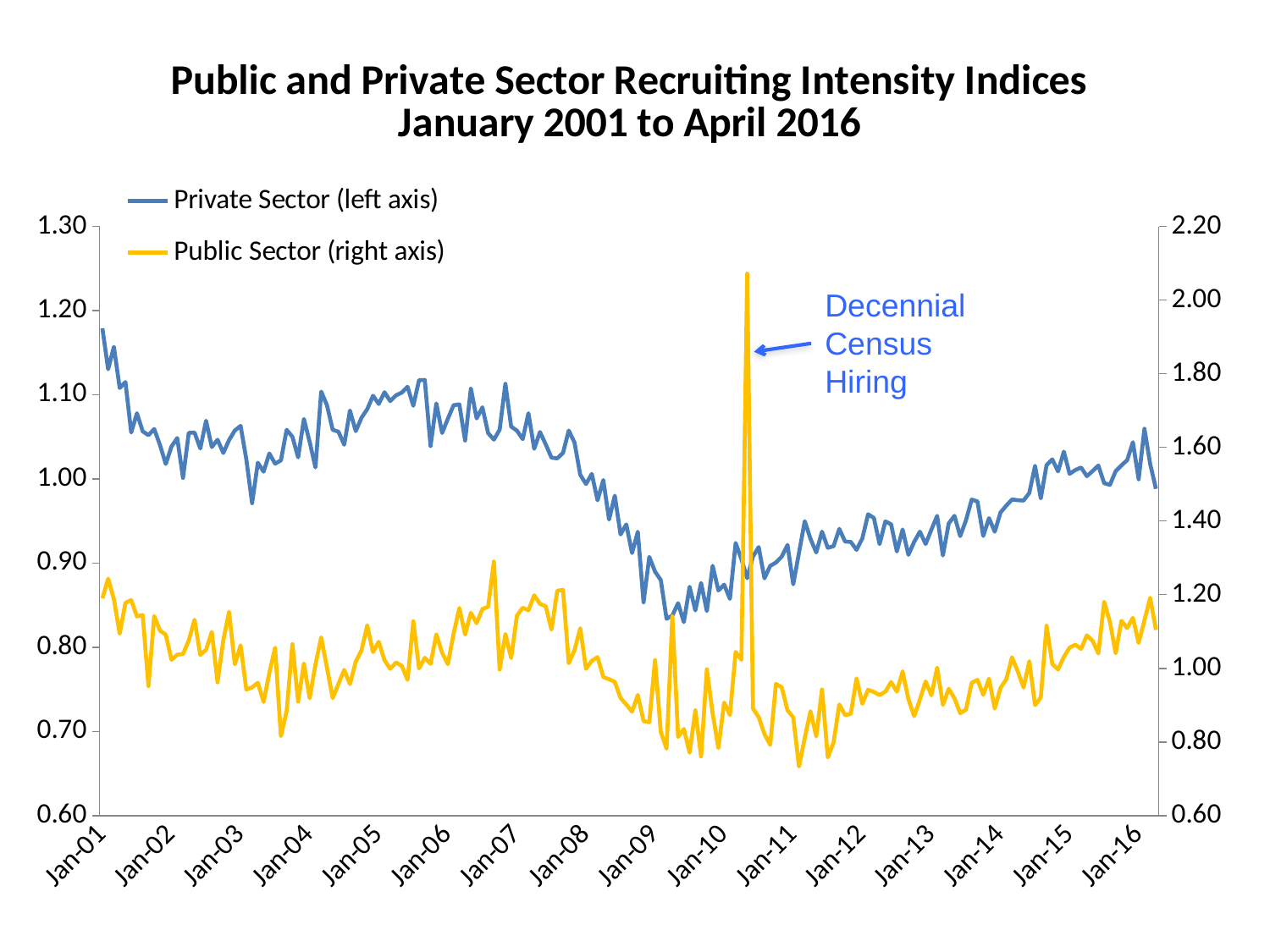
Is the Private Sector value at Jan-01 greater or less than 1.10? greater Which axis is the Public Sector series plotted against? right axis Is the Public Sector value at Jan-01 (right axis) greater or less than 1.40? less What kind of chart is shown on the slide? line chart In which year does the Public Sector series reach its highest point? 2010 Which series shows a sharp spike labelled 'Decennial Census Hiring'? Public Sector (right axis) How many series does the legend list? 2 Does the Private Sector series rise or fall overall between Jan-10 and Jan-16? rise Is the peak value of the Public Sector series (right axis) greater or less than 2.00? greater What does the annotation on the chart attribute the 2010 spike to? Decennial Census Hiring Does the Private Sector series rise or fall between Jan-08 and Jan-09? fall